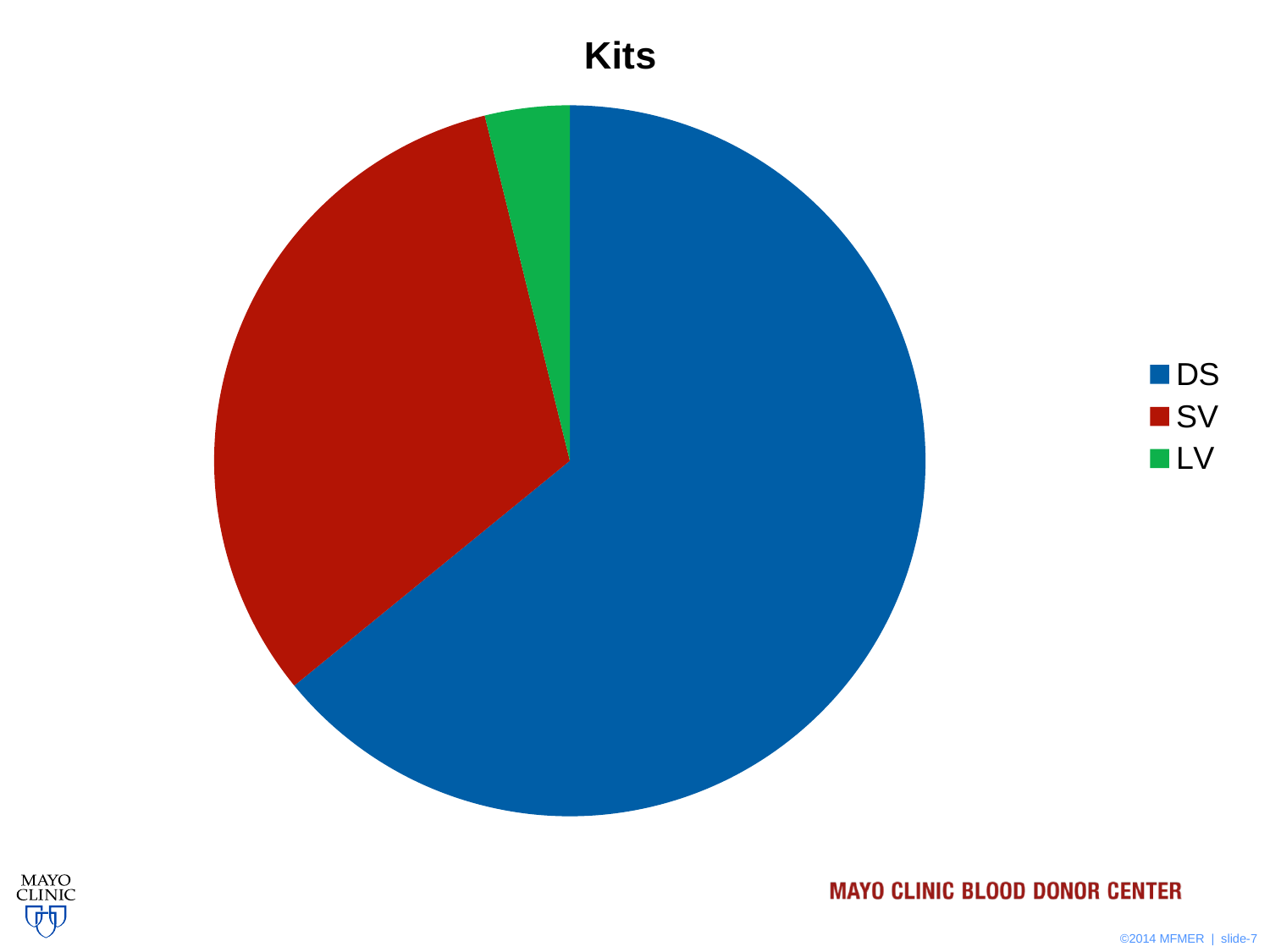
Does the DS slice make up more or less than half of the pie? more Which is larger, the slice for DS or the slice for SV? DS How many slices does the pie chart have? 3 How many entries does the legend list? 3 Which category has the smallest slice of the pie? LV What colour is the slice for DS? blue What kind of chart is shown on the slide? pie chart What is the title of the chart? Kits Which is larger, the slice for SV or the slice for LV? SV Which category has the largest slice of the pie? DS